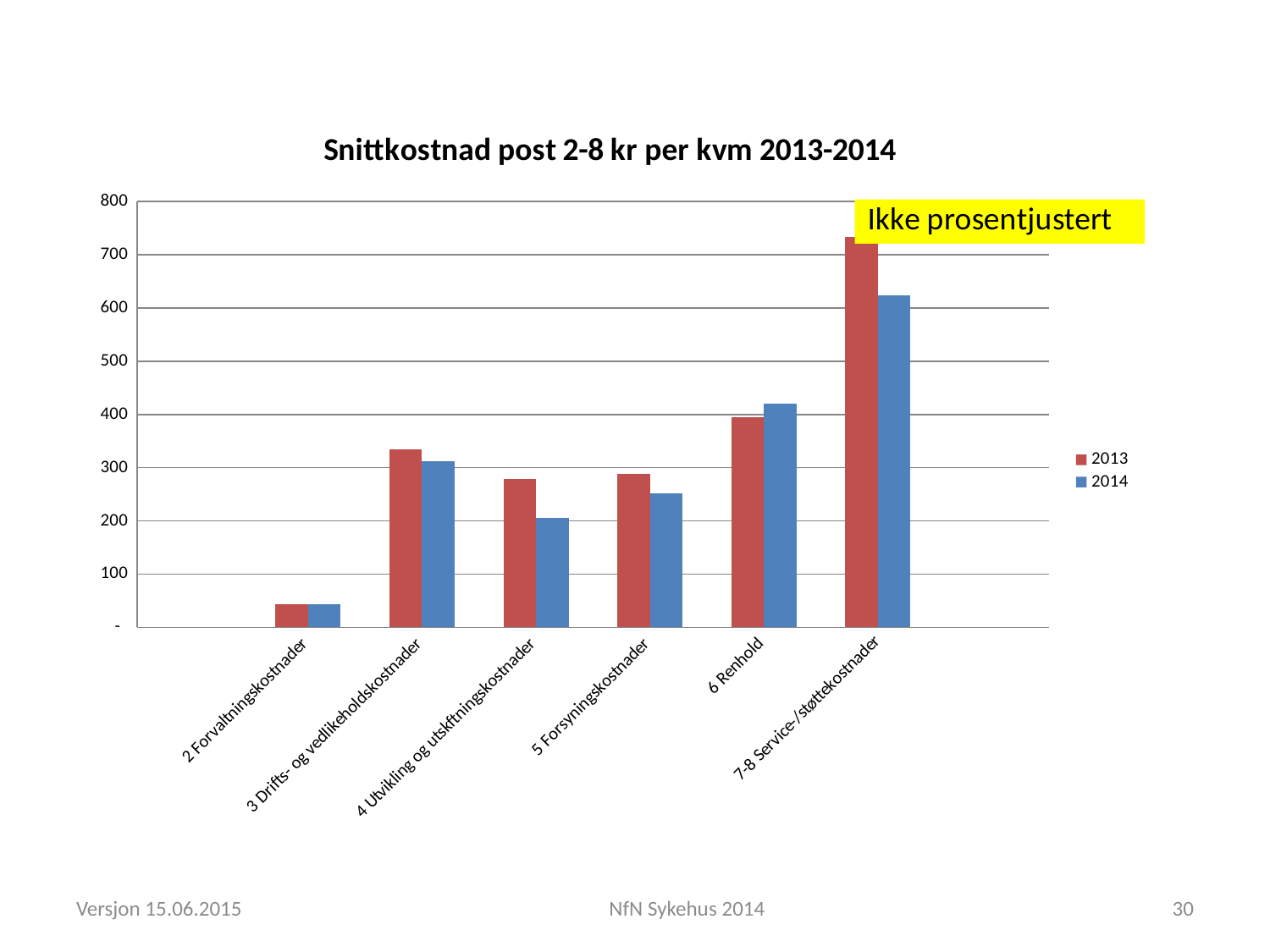
Which colour represents the 2014 series in the legend? Blue What kind of chart is shown on the slide? Bar chart Is the 2014 value for 6 Renhold greater or less than 400? greater For 6 Renhold, which year has the larger value, 2013 or 2014? 2014 What is the title of the chart? Snittkostnad post 2-8 kr per kvm 2013-2014 For 7-8 Service-/støttekostnader, which year has the larger value, 2013 or 2014? 2013 Is the 2013 value for 7-8 Service-/støttekostnader greater or less than 700? greater How many series does the legend list? 2 Which category has the lowest value for 2014? 2 Forvaltningskostnader Is the 2014 value for 4 Utvikling og utskiftningskostnader greater or less than 300? less How many categories are shown on the x axis? 6 Which category has the highest value for 2013? 7-8 Service-/støttekostnader